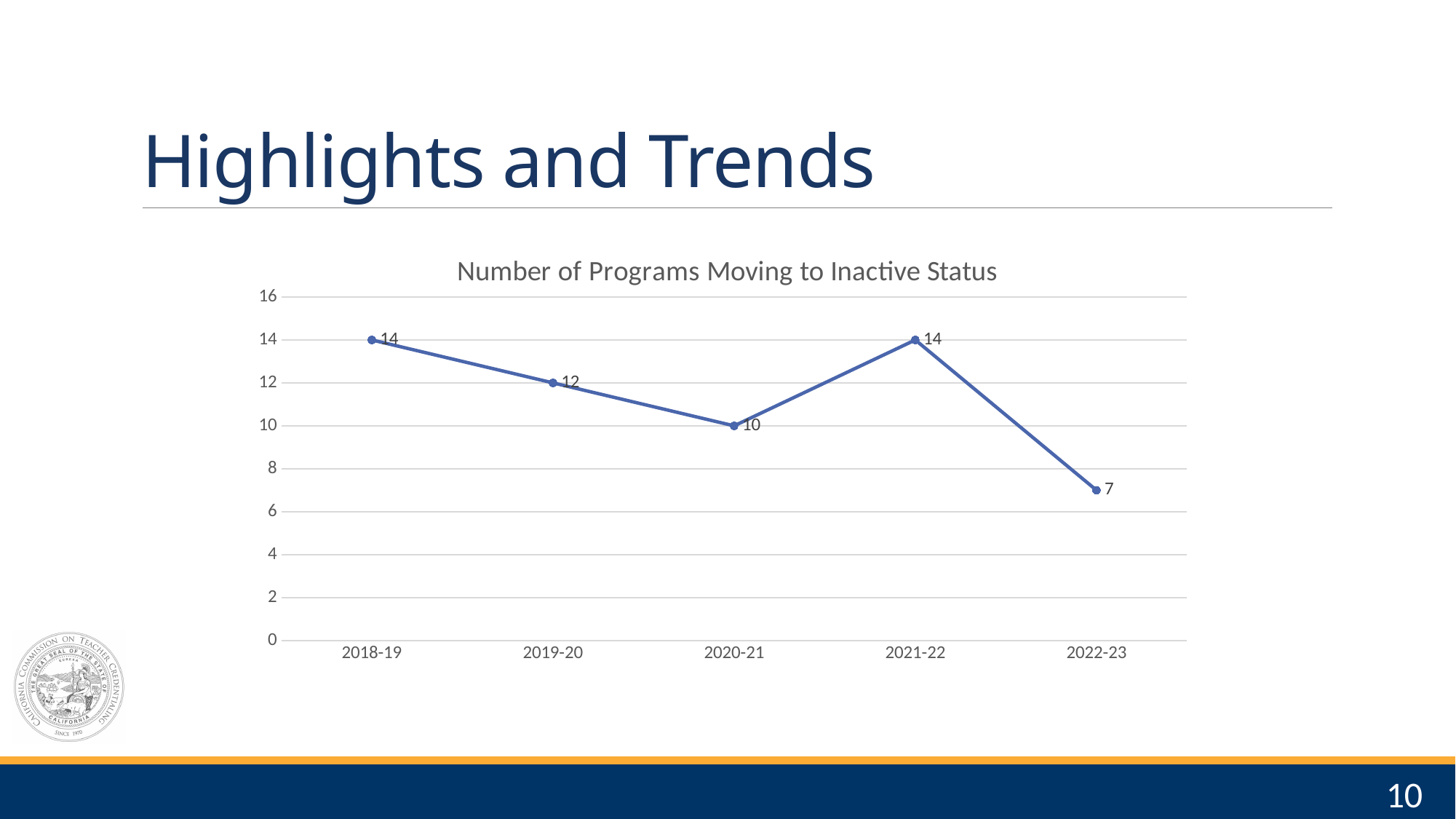
What is the number of programs moving to inactive status in 2020-21? 10 What is the difference between the values for 2018-19 and 2019-20? 2 What is the number of programs moving to inactive status in 2018-19? 14 What is the title of the chart? Number of Programs Moving to Inactive Status What is the difference between the values for 2021-22 and 2022-23? 7 What kind of chart is shown on the slide? line chart Which is larger, the value for 2019-20 or the value for 2020-21? 2019-20 What is the number of programs moving to inactive status in 2022-23? 7 How many years are plotted on the chart? 5 Does the value rise or fall from 2020-21 to 2021-22? rise Which year has the lowest number of programs moving to inactive status? 2022-23 Is the value for 2022-23 greater or less than 8? less